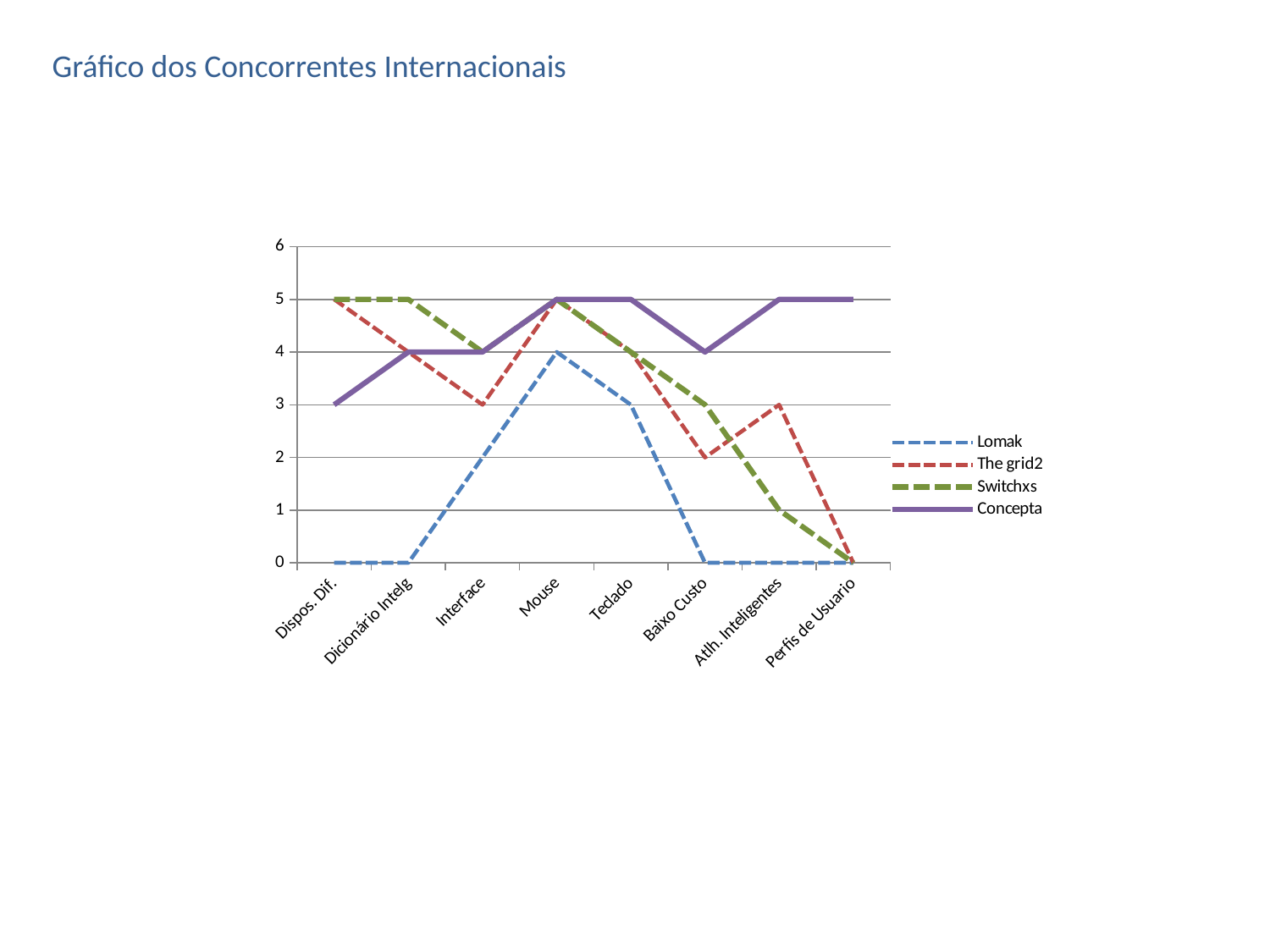
What kind of chart is shown on the slide? line chart What is the value for Concepta at Dispos. Dif.? 3 Which series has the highest value at Perfis de Usuario? Concepta How many categories are shown on the x axis? 8 What is the value for Switchxs at Atlh. Inteligentes? 1 Which series has the lowest value at Dispos. Dif.? Lomak Which is larger at Teclado, the value for Lomak or the value for Concepta? Concepta What is the value for Concepta at Mouse? 5 What is the value for The grid2 at Baixo Custo? 2 What is the difference between The grid2 and Switchxs at Atlh. Inteligentes? 2 What is the value for Lomak at Mouse? 4 How many series does the legend list? 4